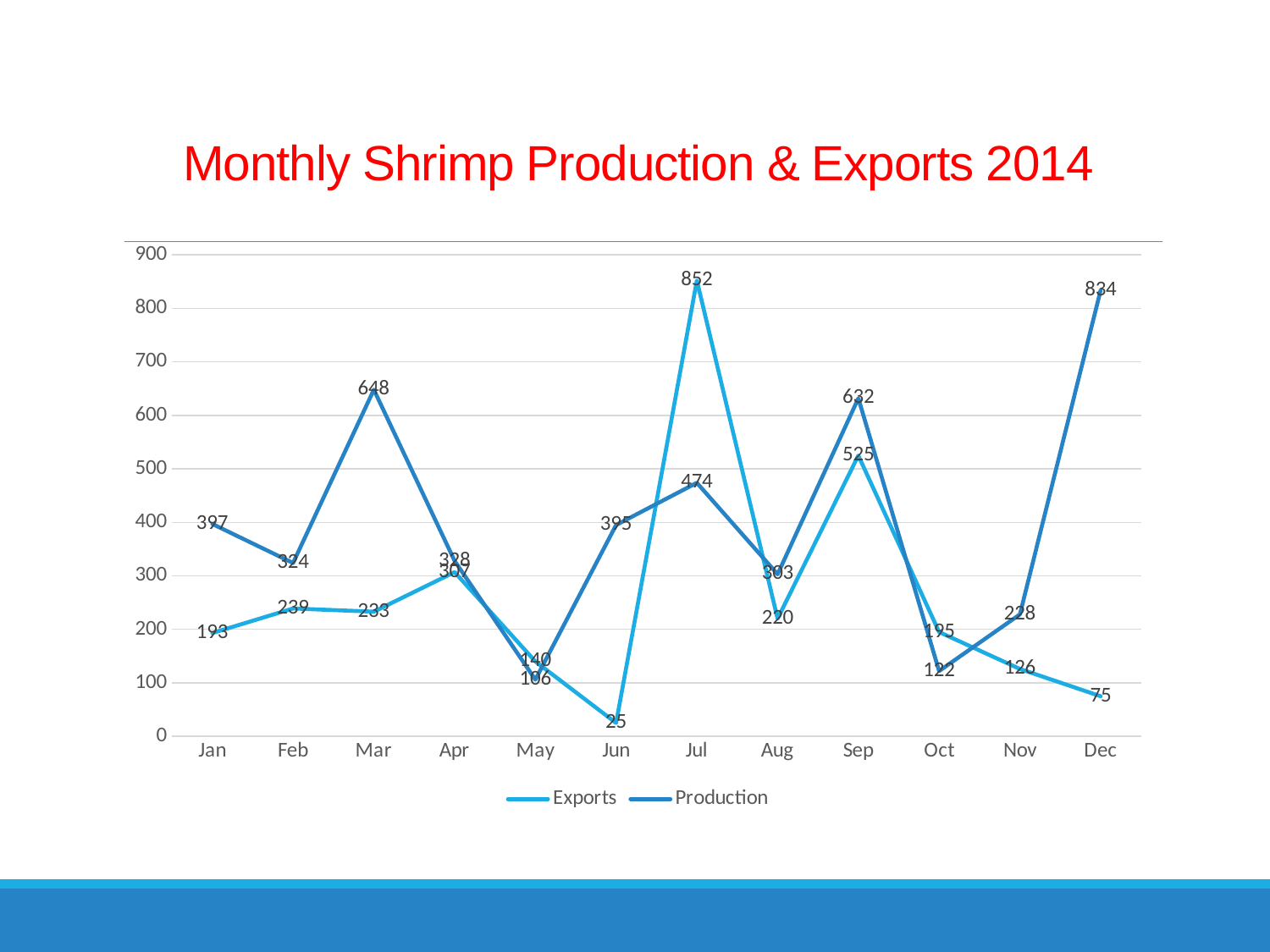
What is the Exports value for Jun? 25 In Sep, which is larger, Production or Exports? Production How many series does the legend list? 2 What is the Exports value for Jul? 852 Which month has the highest Production value? Dec Do the Exports values rise or fall from Sep to Dec? Fall How many months are shown on the x axis? 12 What kind of chart is shown on the slide? Line chart What is the difference between the Production values for Dec and Mar? 186 What is the Production value for Mar? 648 Which month has the lowest Exports value? Jun What is the Production value for Oct? 122